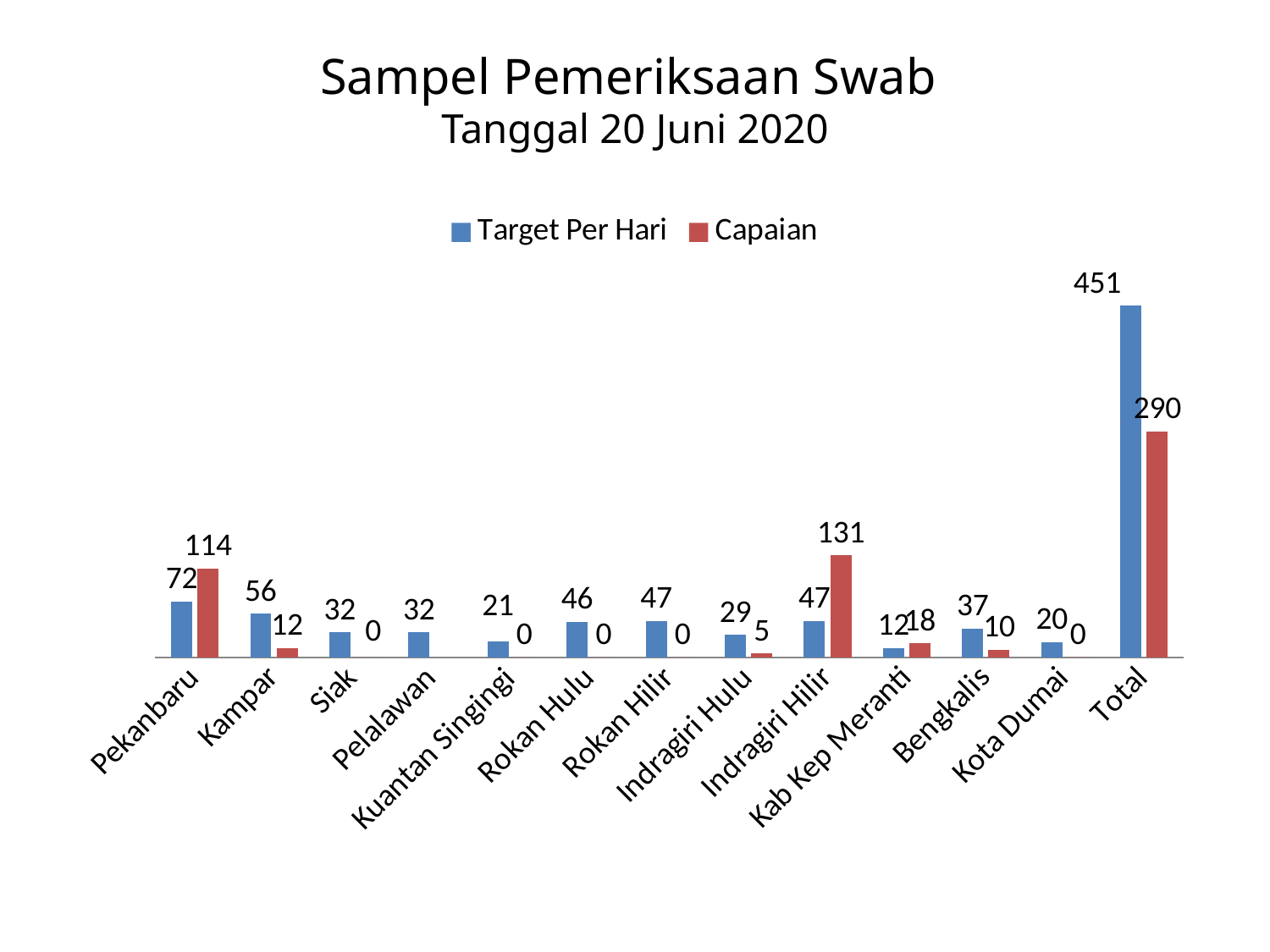
Which is larger for Bengkalis, Target Per Hari or Capaian? Target Per Hari What is the difference between the Target Per Hari and Capaian values for Total? 161 What is the Capaian value for Kampar? 12 Excluding Total, which category has the lowest Target Per Hari value? Kab Kep Meranti What is the Capaian value for Indragiri Hilir? 131 How many categories are shown on the x axis? 13 How many series does the legend list? 2 Excluding Total, which category has the highest Capaian value? Indragiri Hilir What is the Target Per Hari value for Pekanbaru? 72 What is the difference between the Capaian and Target Per Hari values for Pekanbaru? 42 What kind of chart is shown on the slide? Bar chart What is the Target Per Hari value for Total? 451